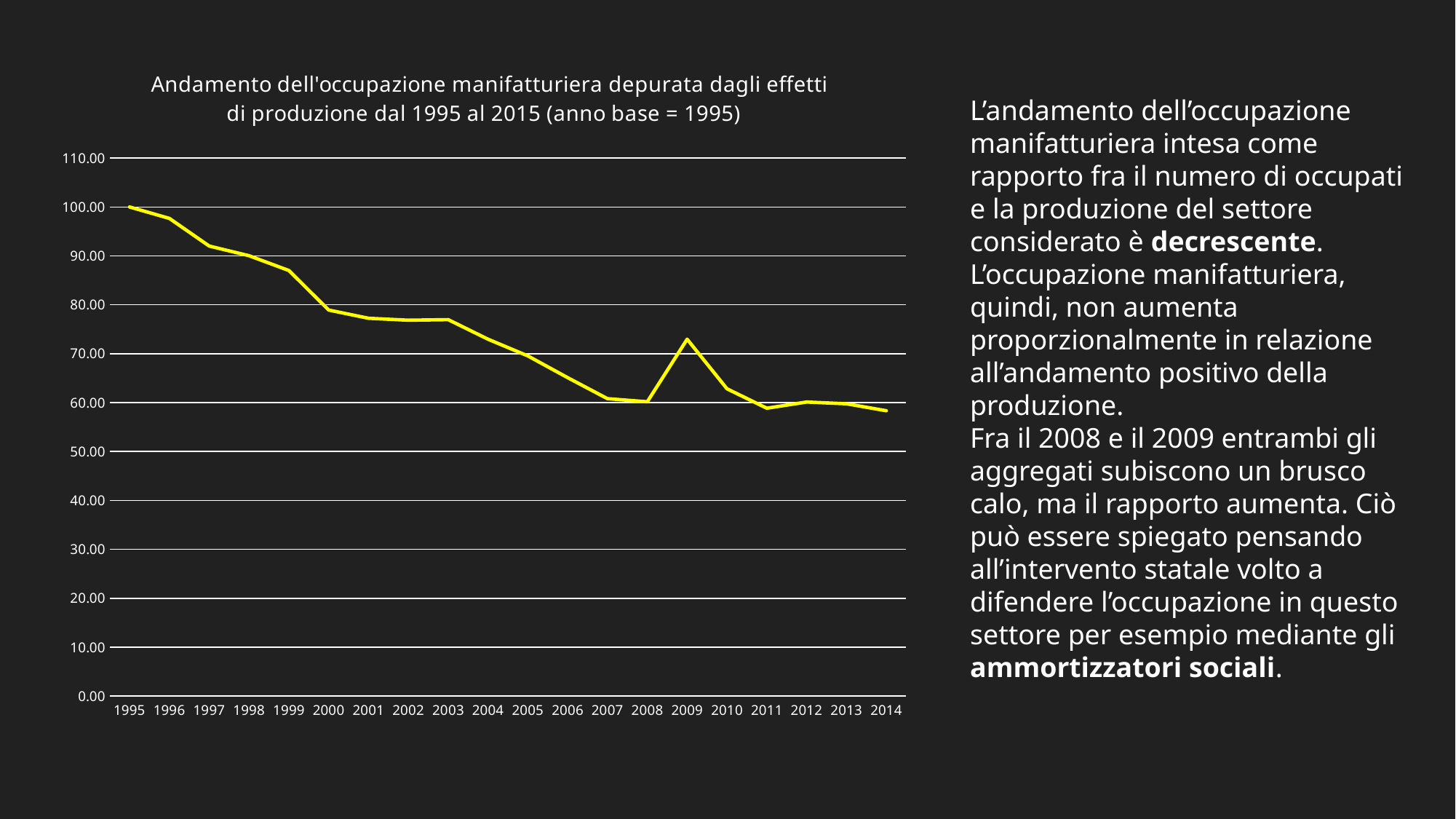
What is the value for 1995 in the chart? 100.00 Which year has the highest value in the chart? 1995 Is the value for 1997 greater or less than 90? greater Is the value for 2009 greater or less than 70? greater Is the value for 2003 greater or less than 80? less Which year has the larger value, 2008 or 2009? 2009 Which year has the larger value, 1995 or 2014? 1995 What kind of chart is shown on the slide? line chart How many years are plotted along the x axis of the chart? 20 What colour is the line in the chart? yellow Overall, do the values rise or fall from 1995 to 2014? fall